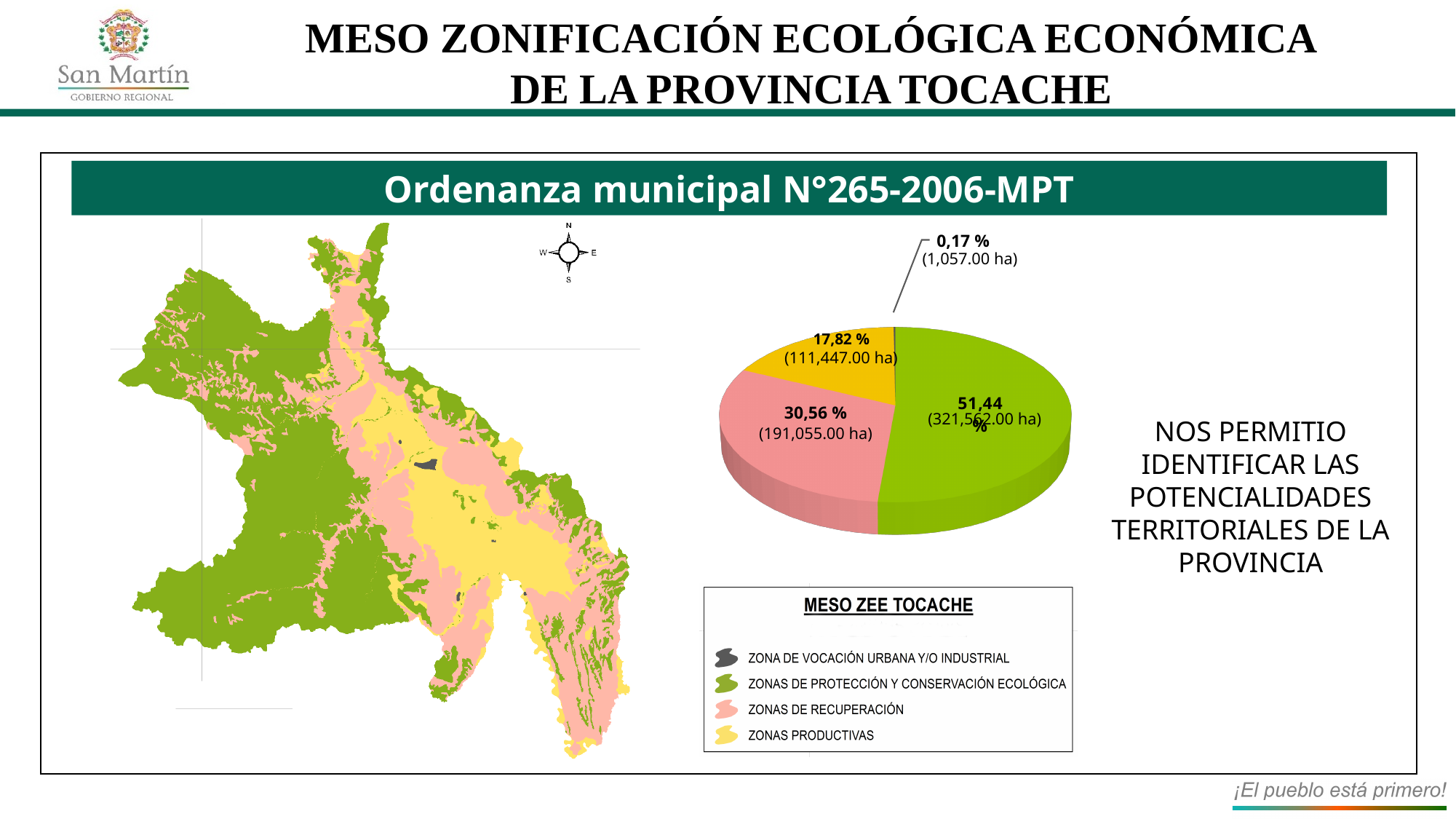
What percentage is shown for the green slice of the pie chart? 51,44 % How many slices does the pie chart have? 4 Which is larger in the pie chart, the pink slice or the yellow slice? the pink slice What kind of chart is shown on the right side of the slide? pie chart Which slice of the pie chart has the smallest share? the dark gray slice (0,17 %) What is the difference in percentage points between the green slice and the pink slice of the pie chart? 20,88 What area in hectares is shown for the pink slice of the pie chart? 191,055.00 ha What percentage is shown for the yellow slice of the pie chart? 17,82 % What is the title of the legend box below the pie chart? MESO ZEE TOCACHE What area in hectares is shown for the smallest slice of the pie chart? 1,057.00 ha Which slice of the pie chart has the largest share? the green slice (51,44 %) According to the legend, which zone category does the green colour represent? ZONAS DE PROTECCIÓN Y CONSERVACIÓN ECOLÓGICA